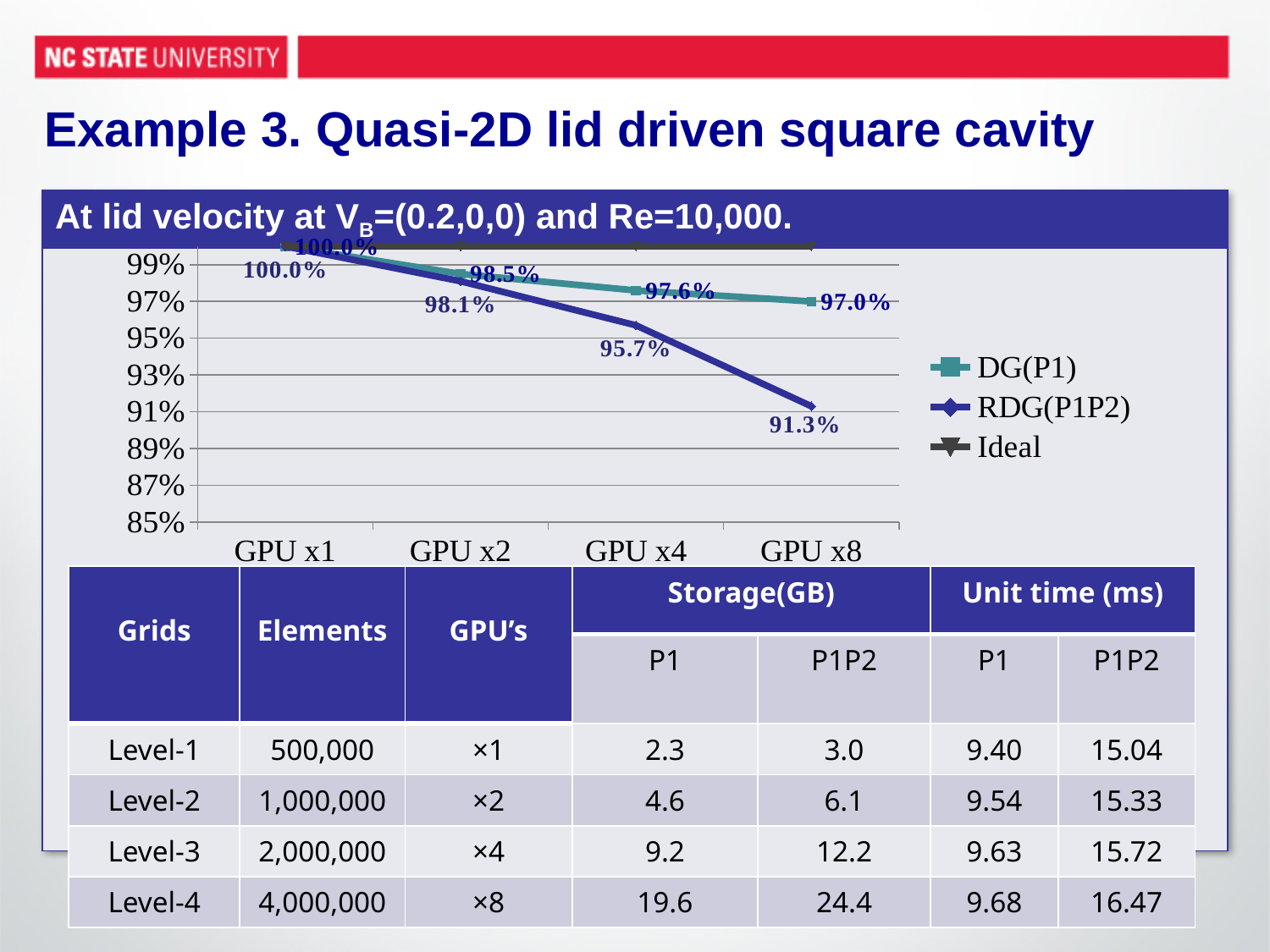
What is the value for DG(P1) at GPU x2? 98.5% How many GPU categories are shown on the x axis? 4 At which GPU count is the RDG(P1P2) value lowest? GPU x8 Which is larger at GPU x4, DG(P1) or RDG(P1P2)? DG(P1) How many series does the legend list? 3 What kind of chart is shown on the slide? line chart What is the value for DG(P1) at GPU x8? 97.0% What is the difference between the DG(P1) and RDG(P1P2) values at GPU x8? 5.7% What is the value for RDG(P1P2) at GPU x4? 95.7% What is the value for RDG(P1P2) at GPU x8? 91.3% Is the value for RDG(P1P2) at GPU x8 greater or less than 93%? less Does the RDG(P1P2) series rise or fall from GPU x1 to GPU x8? fall